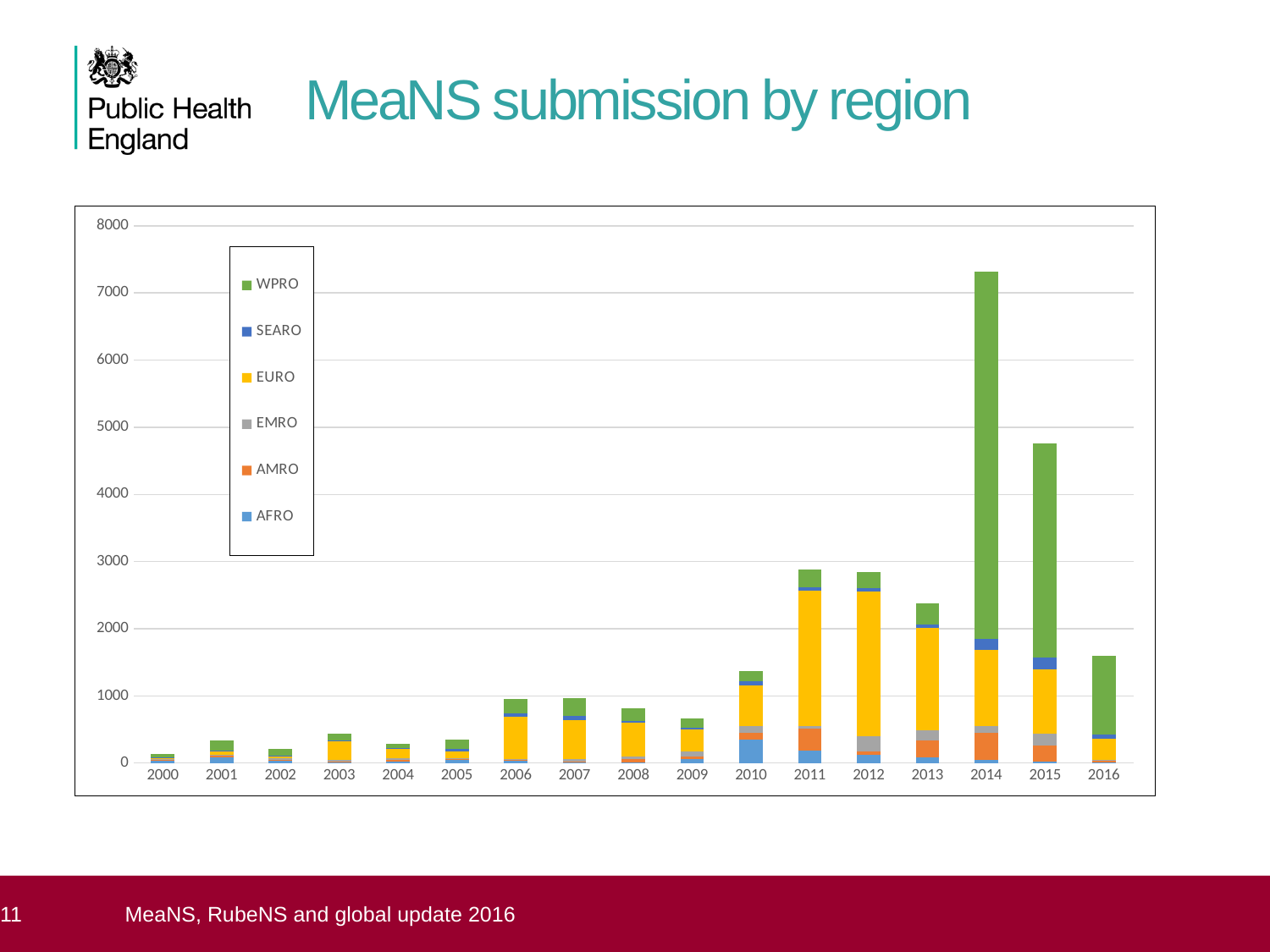
How many years are shown along the x axis? 17 What is the title of the chart? MeaNS submission by region Which year has the highest total number of submissions? 2014 Is the total for 2011 greater or less than 2000? greater Which year has the lowest total number of submissions? 2000 Is the total for 2009 greater or less than 1000? less How many series does the legend list? 6 Is the total for 2015 greater or less than 5000? less What kind of chart is shown on the slide? Stacked bar chart Which year has the larger total, 2014 or 2015? 2014 Which year has the larger total, 2013 or 2016? 2013